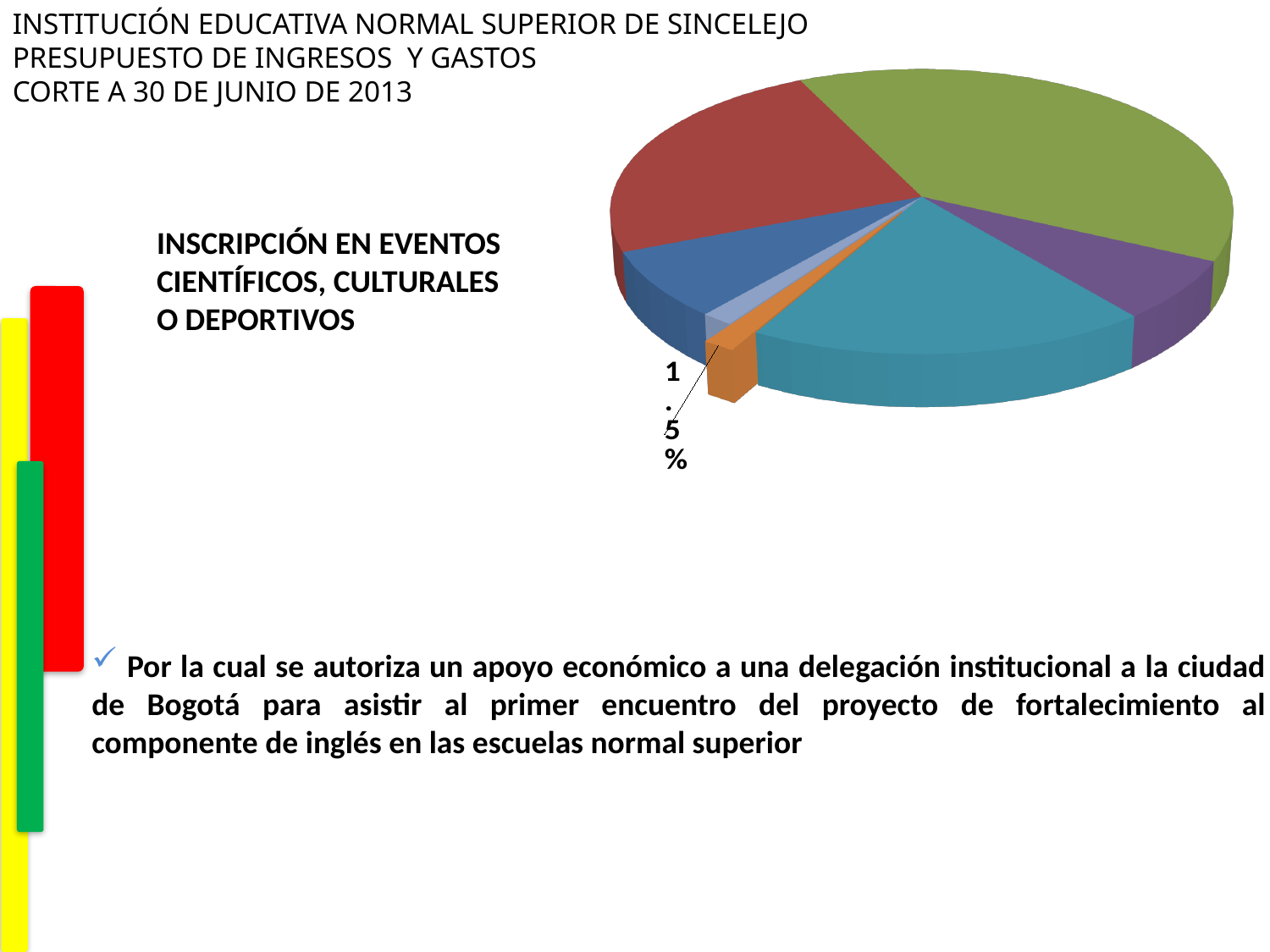
How many slices does the pie chart have? 7 Which colour slice is the largest in the pie chart? green What percentage is printed on the exploded (pulled-out) slice of the pie chart? 1.5% Which slice of the pie chart is pulled out from the rest? the orange slice Which is larger in the pie chart, the teal slice or the purple slice? the teal slice What expense item is named in bold text next to the pie chart? INSCRIPCIÓN EN EVENTOS CIENTÍFICOS, CULTURALES O DEPORTIVOS What kind of chart is shown on the slide? pie chart Which is larger in the pie chart, the green slice or the orange slice? the green slice What share of the pie does the orange slice labelled on the chart represent? 1.5%